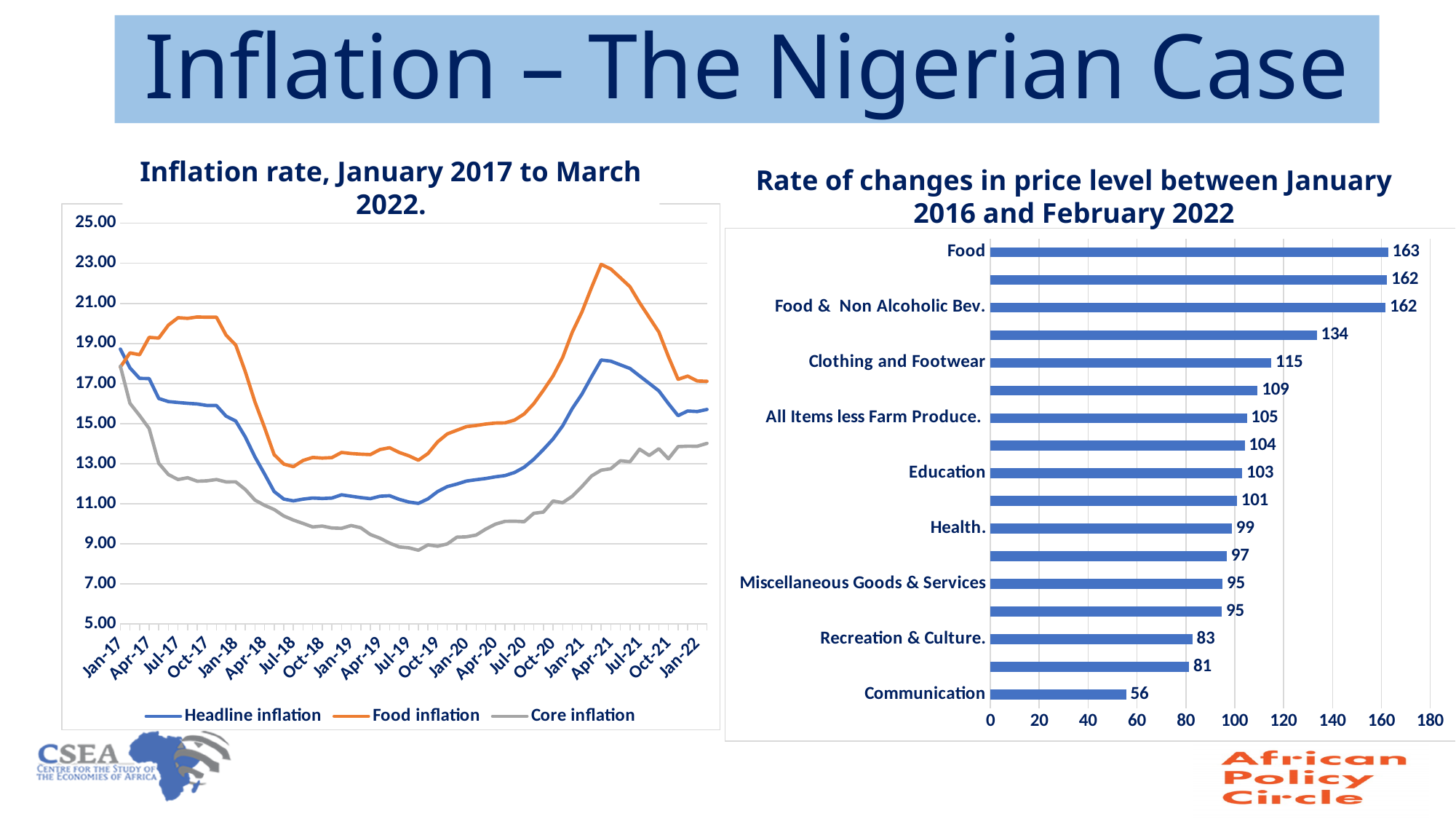
In the chart 'Rate of changes in price level between January 2016 and February 2022', what is the value for Food? 163 In the chart 'Rate of changes in price level between January 2016 and February 2022', which category has the highest value? Food How many bars are plotted in the chart 'Rate of changes in price level between January 2016 and February 2022'? 17 In the chart 'Rate of changes in price level between January 2016 and February 2022', what is the value for Communication? 56 How many series does the legend of the chart 'Inflation rate, January 2017 to March 2022' list? 3 In the chart 'Inflation rate, January 2017 to March 2022', is the value of Food inflation at Apr-21 greater or less than 21.00? greater What kind of chart is the chart on the right of the slide? Bar chart In the chart 'Rate of changes in price level between January 2016 and February 2022', which category has the lowest value? Communication In the chart 'Rate of changes in price level between January 2016 and February 2022', what is the difference between the values for Food and Communication? 107 In the chart 'Rate of changes in price level between January 2016 and February 2022', what is the value for Clothing and Footwear? 115 What kind of chart is the chart 'Inflation rate, January 2017 to March 2022'? Line chart In the chart 'Rate of changes in price level between January 2016 and February 2022', which is larger, the value for Education or the value for Health? Education